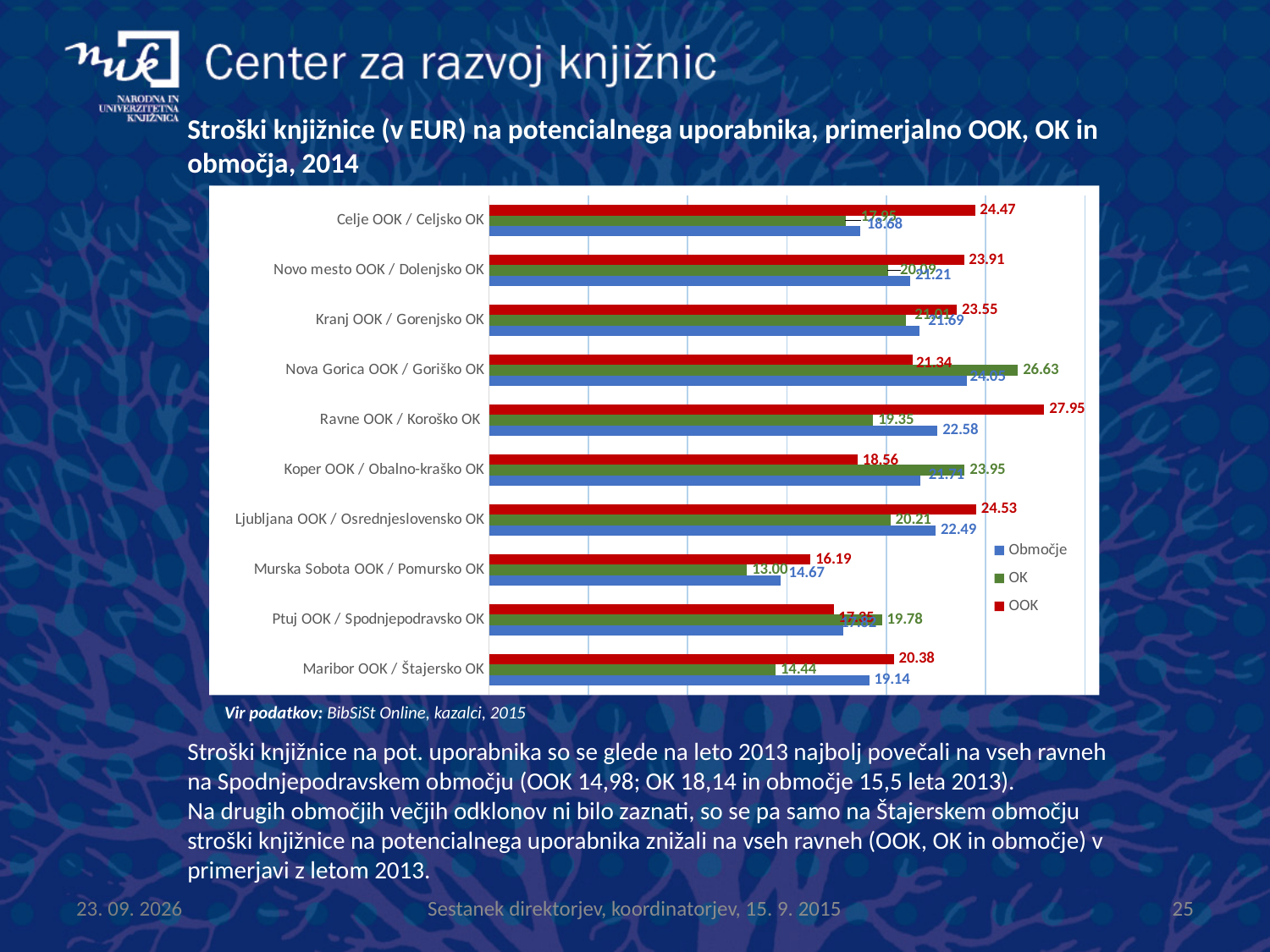
What is the Območje value for Murska Sobota OOK / Pomursko OK? 14.67 What is the OK value for Nova Gorica OOK / Goriško OK? 26.63 What is the OOK value for Maribor OOK / Štajersko OK? 20.38 What is the difference between the OOK and OK values for Maribor OOK / Štajersko OK? 5.94 How many series does the legend list? 3 What is the OOK value for Ravne OOK / Koroško OK? 27.95 For Koper OOK / Obalno-kraško OK, which is larger, the OOK value or the OK value? OK What kind of chart is shown on the slide? Bar chart How many categories are shown on the chart? 10 Which category has the lowest OK value? Murska Sobota OOK / Pomursko OK What is the difference between the OOK and OK values for Ravne OOK / Koroško OK? 8.60 Which category has the highest OOK value? Ravne OOK / Koroško OK